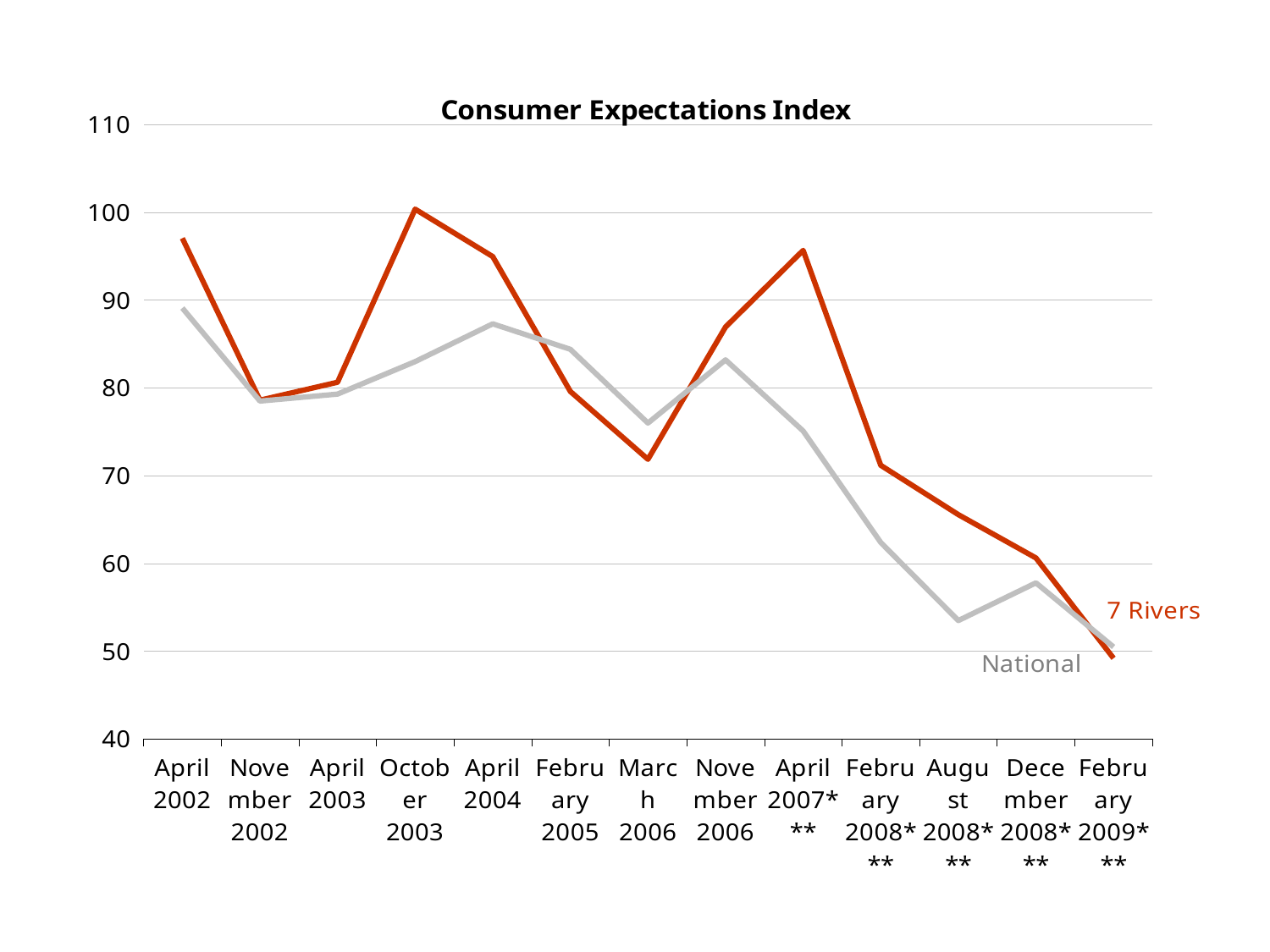
Is the 7 Rivers value for April 2002 greater or less than 90? greater Is the National value for December 2008*** greater or less than 60? less Overall, do the values of the 7 Rivers series rise or fall from April 2002 to February 2009***? fall At which time point does the 7 Rivers series reach its highest value? October 2003 What kind of chart is shown on the slide? line chart In March 2006, which series has the higher value, 7 Rivers or National? National At which time point does the 7 Rivers series reach its lowest value? February 2009*** Is the National value for February 2008*** greater or less than 60? greater What is the title of the chart? Consumer Expectations Index How many series are plotted on the chart? 2 How many time points are shown along the x axis? 13 In April 2007***, which series has the higher value, 7 Rivers or National? 7 Rivers